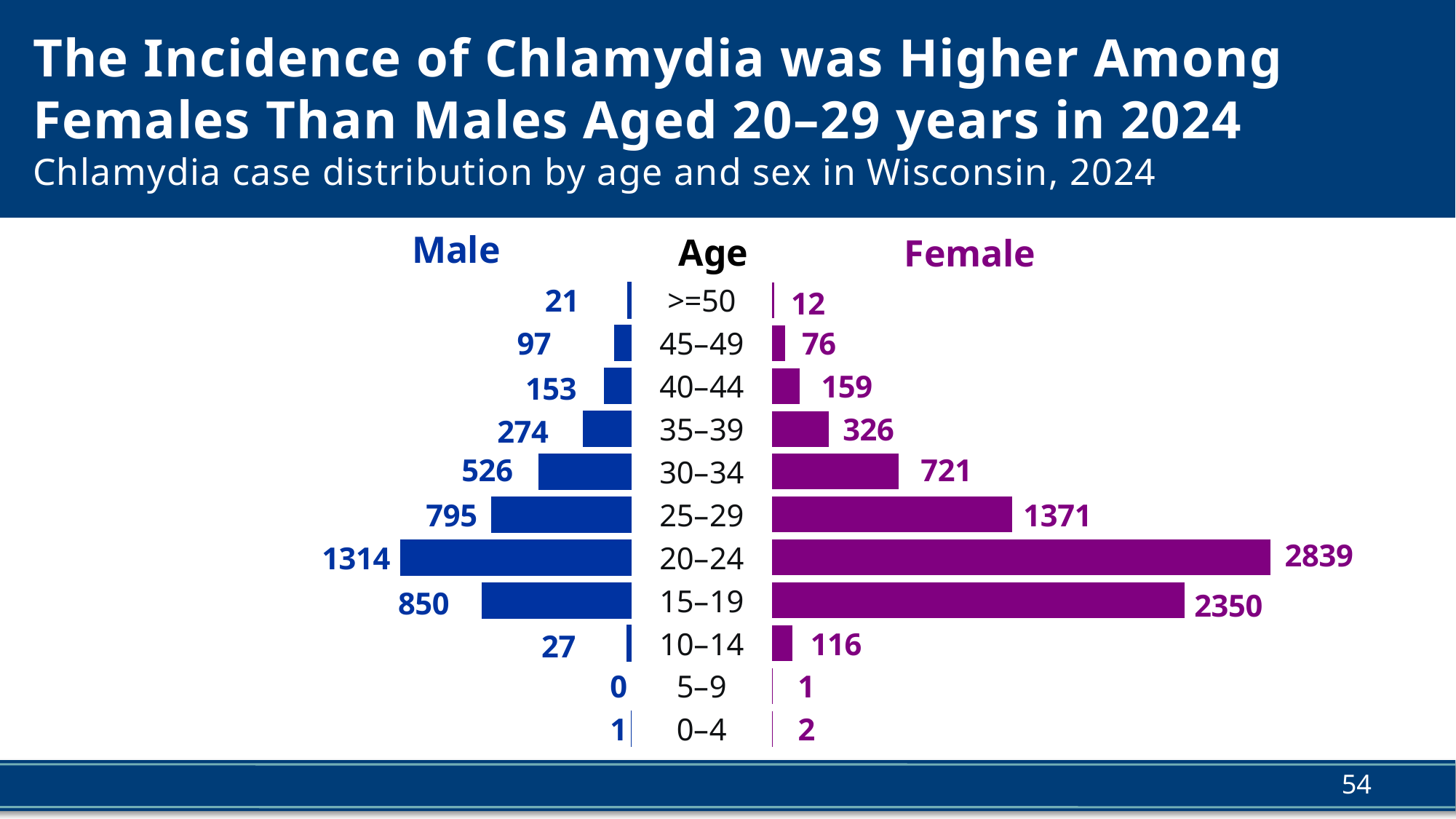
How many female chlamydia cases were in the 15–19 age group? 2350 How many male chlamydia cases were in the 20–24 age group? 1314 What colour are the bars for female cases? Purple What type of chart is shown on the slide? Bar chart Which age group had the highest number of male cases? 20–24 In the 45–49 age group, were there more male or female cases? Male Which age group had the lowest number of male cases? 5–9 Which age group had the highest number of female cases? 20–24 What is the difference between female and male cases in the 25–29 age group? 576 What is the difference between female and male cases in the 20–24 age group? 1525 How many age groups are shown on the chart? 11 How many female cases were in the 30–34 age group? 721